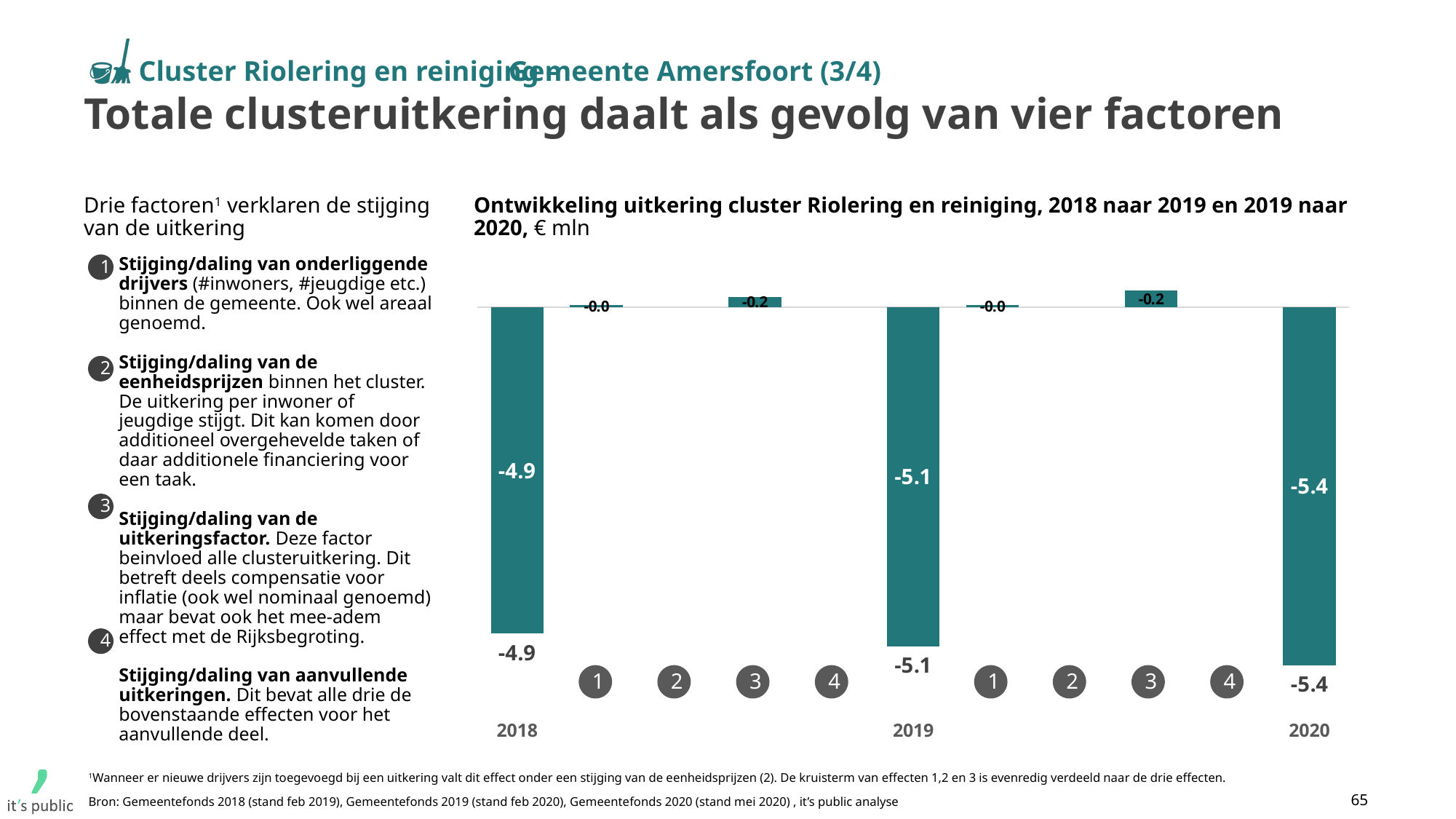
Which year has the lowest (most negative) total uitkering value? 2020 What is the difference between the 2020 total (-5.4) and the 2018 total (-4.9)? 0.5 What is the value of the total uitkering bar for 2019? -5.1 What is the value of the total uitkering bar for 2018? -4.9 In what unit are the values in the chart expressed? € mln What is the value of the total uitkering bar for 2020? -5.4 What kind of chart is used to show the development of the uitkering? Bar chart How many year totals (2018, 2019, 2020) are shown in the chart? 3 Which year has the highest (least negative) total uitkering value? 2018 What is the value labelled for factor 1 between 2019 and 2020? -0.0 What is the value labelled for factor 3 between 2018 and 2019? -0.2 Which is more negative, the total for 2019 or the total for 2020? 2020